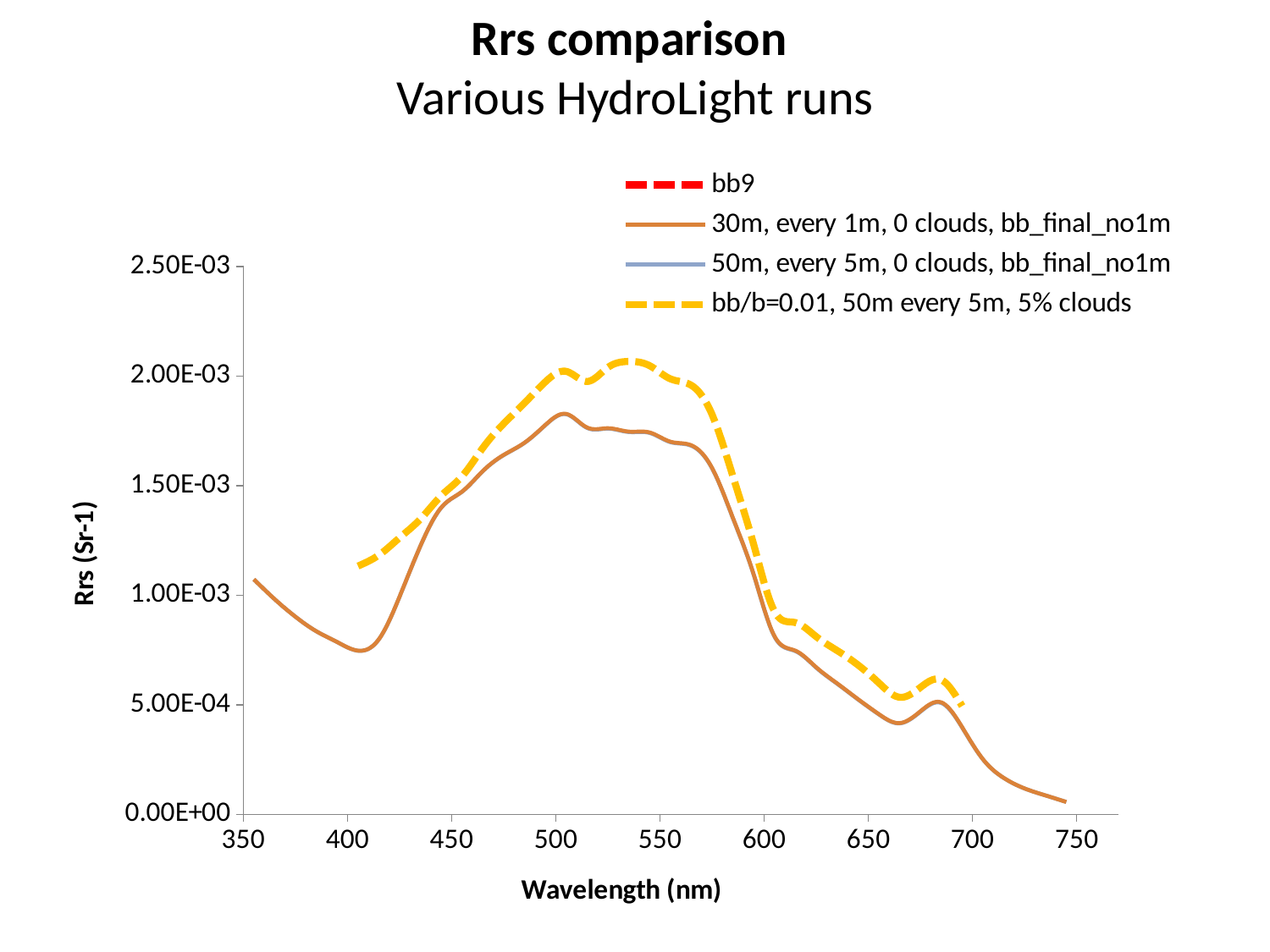
What kind of chart is shown on the slide? line chart Is the value of the '30m, every 1m, 0 clouds, bb_final_no1m' series at 400 nm greater or less than 1.00E-03? less Is the value of the 'bb/b=0.01, 50m every 5m, 5% clouds' series at 550 nm greater or less than 1.50E-03? greater At 550 nm, which series has the higher value: 'bb/b=0.01, 50m every 5m, 5% clouds' or '30m, every 1m, 0 clouds, bb_final_no1m'? bb/b=0.01, 50m every 5m, 5% clouds Is the value of the '30m, every 1m, 0 clouds, bb_final_no1m' series at 700 nm greater or less than 5.00E-04? less Does the '30m, every 1m, 0 clouds, bb_final_no1m' series rise or fall between 450 nm and 500 nm? rise Does the '30m, every 1m, 0 clouds, bb_final_no1m' series rise or fall between 600 nm and 650 nm? fall What is the title of the chart? Rrs comparison Various HydroLight runs How many series does the legend list? 4 What is the label of the x axis? Wavelength (nm)